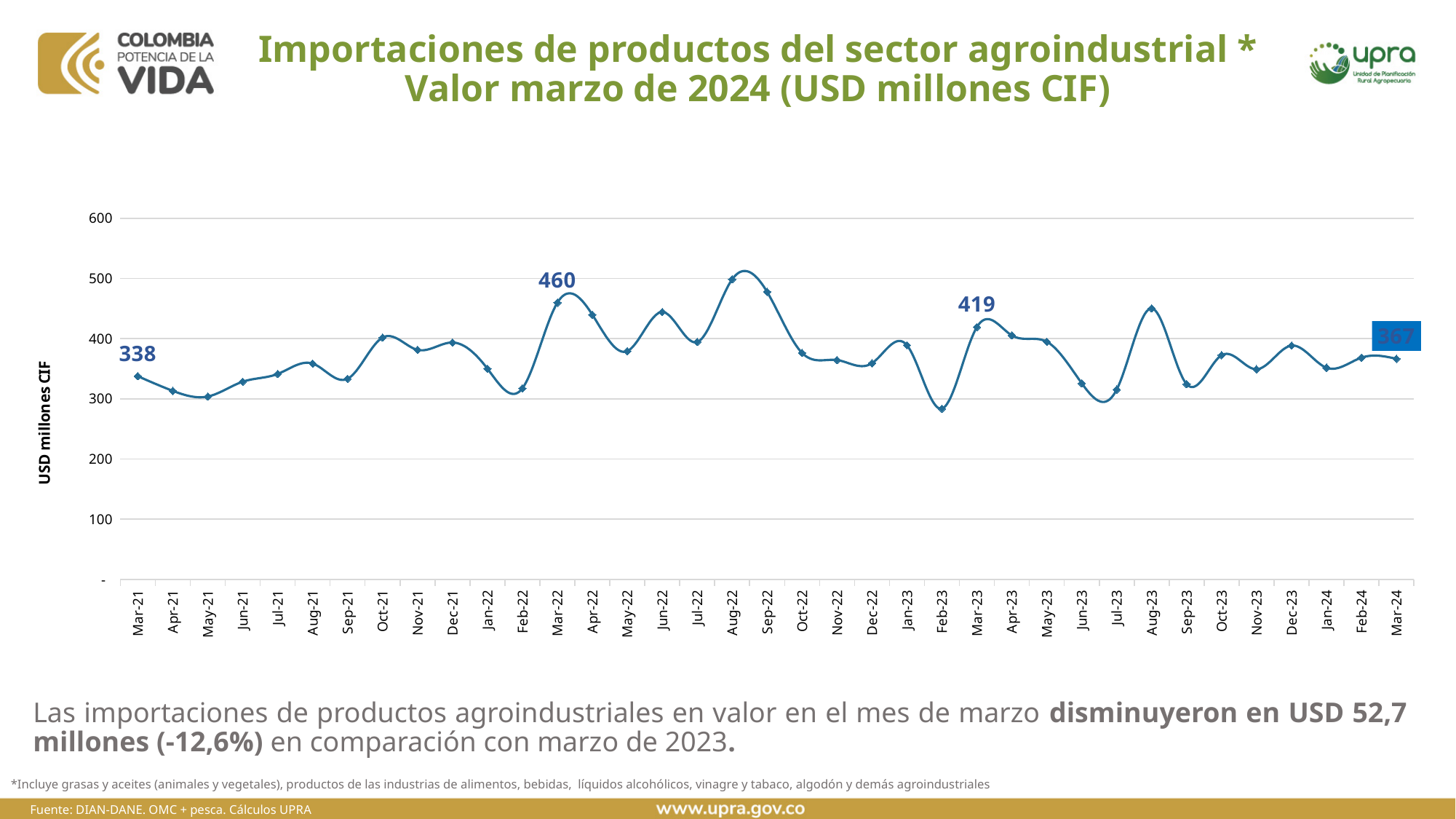
Which month has the highest value on the chart? Aug-22 What is the value for Mar-24? 367 What is the label of the vertical axis? USD millones CIF How many monthly data points are plotted on the chart? 37 What is the difference between the values for Mar-22 and Mar-23? 41 What is the value for Mar-23? 419 Which is larger, the value for Mar-21 or the value for Mar-24? Mar-24 Is the value for Aug-22 greater or less than 400? greater Which month has the lowest value on the chart? Feb-23 What is the value for Mar-22? 460 What is the value for Mar-21? 338 What type of chart is shown on the slide? line chart